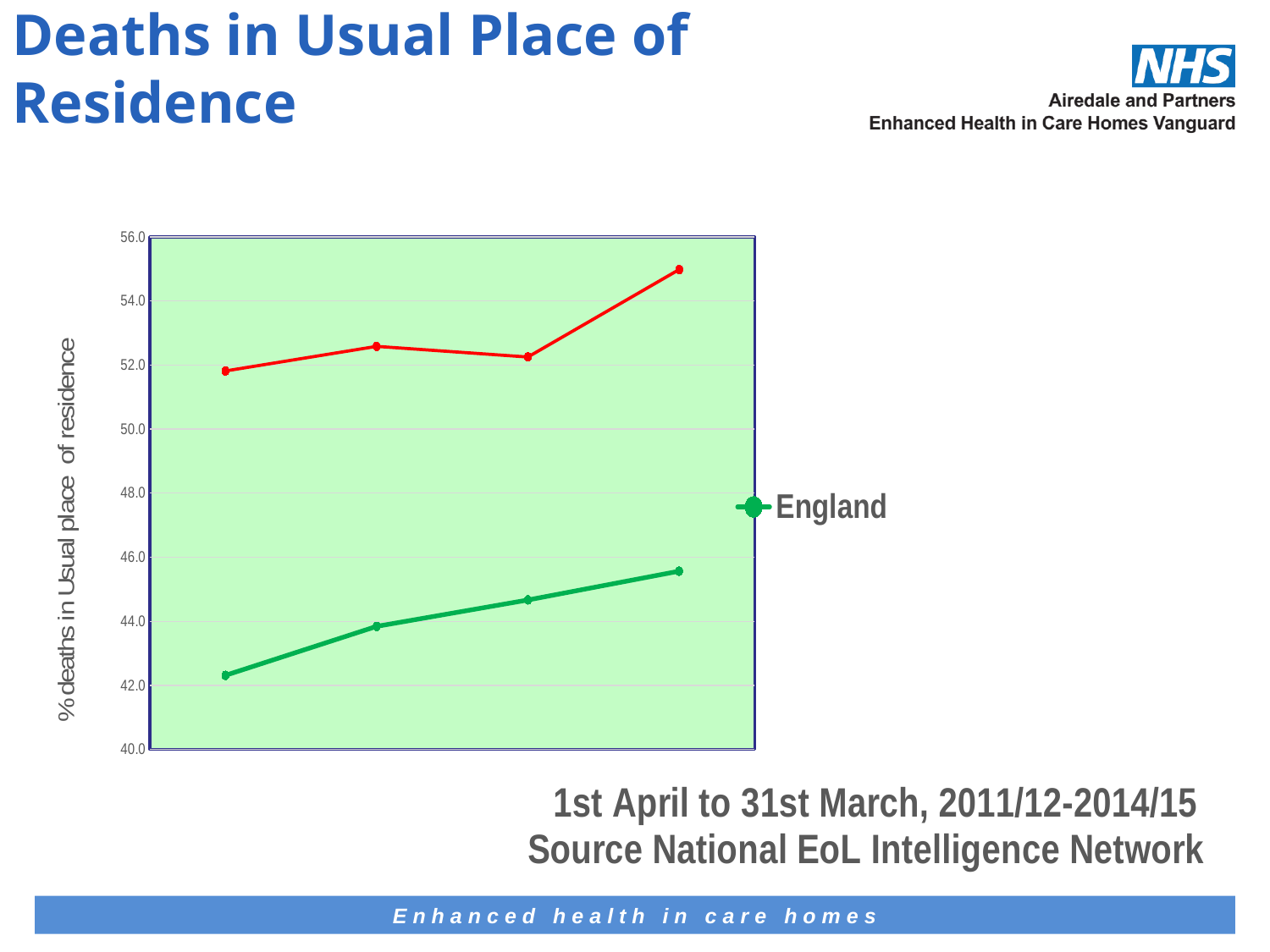
Is the first point of the England line greater or less than 44.0? less Is the last point of the England line greater or less than 46.0? less Is the first point of the red line greater or less than 50.0? greater Which point of the red line is the highest? the last (fourth) point How many data points does the England line have? 4 What is the title of the vertical axis? % deaths in Usual place of residence What kind of chart is shown on the slide? line chart At the last point, which line is higher, the red line or the England line? the red line Which series is named in the chart's legend? England How many series does the chart's legend list? 1 Does the England line rise or fall from left to right? rise